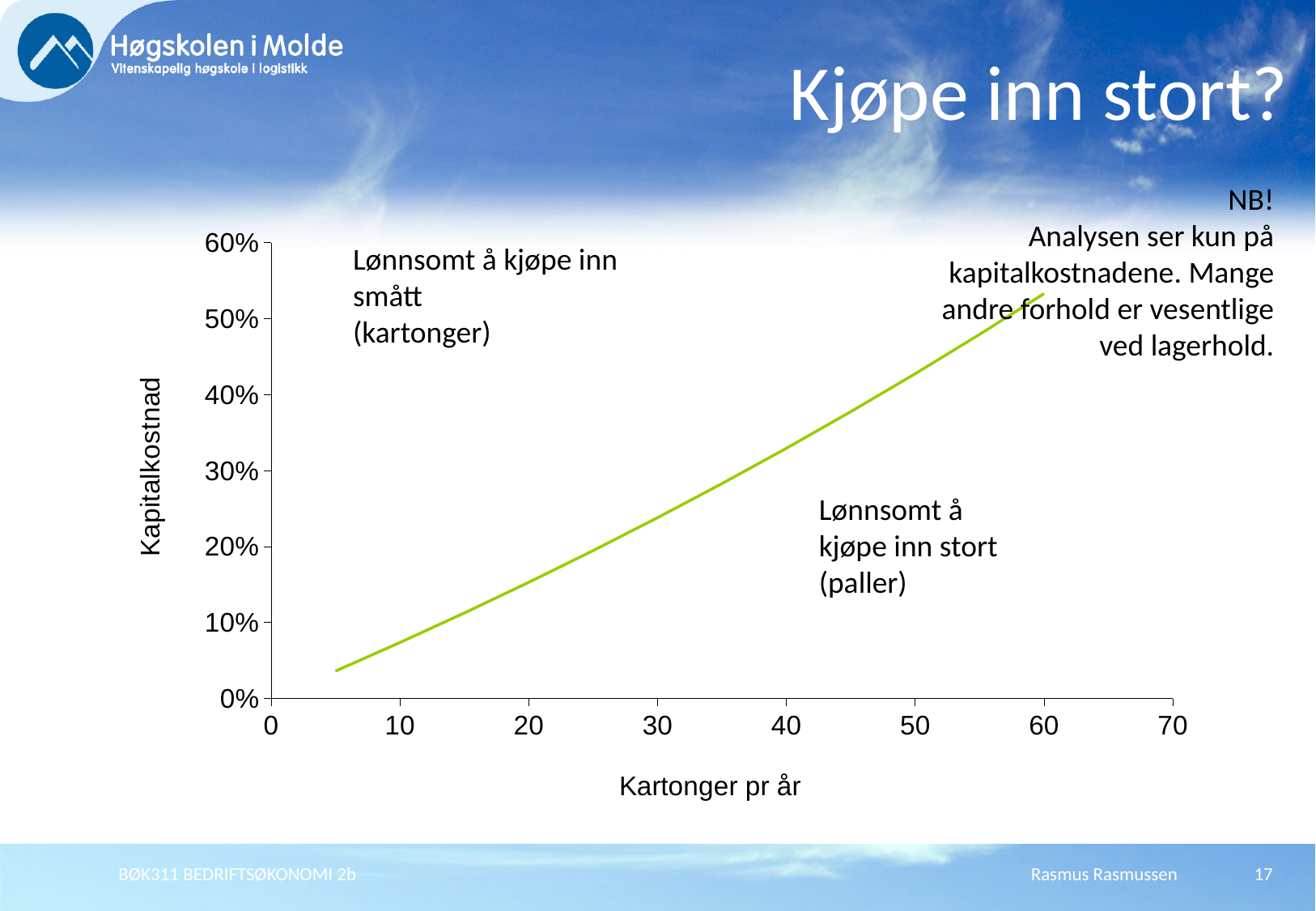
What is the label of the y axis? Kapitalkostnad Which is larger, the capital cost at 50 cartons per year or at 20 cartons per year? at 50 cartons per year What is the highest value shown on the y axis? 60% Does the capital cost (Kapitalkostnad) rise or fall as the number of cartons per year (Kartonger pr år) increases? rise Is the value of the line at 20 cartons per year greater or less than 10%? greater How many lines are plotted on the chart? 1 Is the value of the line at 30 cartons per year greater or less than 20%? greater Is the value of the line at 60 cartons per year greater or less than 50%? greater What kind of chart is shown on the slide? line chart What is the label of the x axis? Kartonger pr år